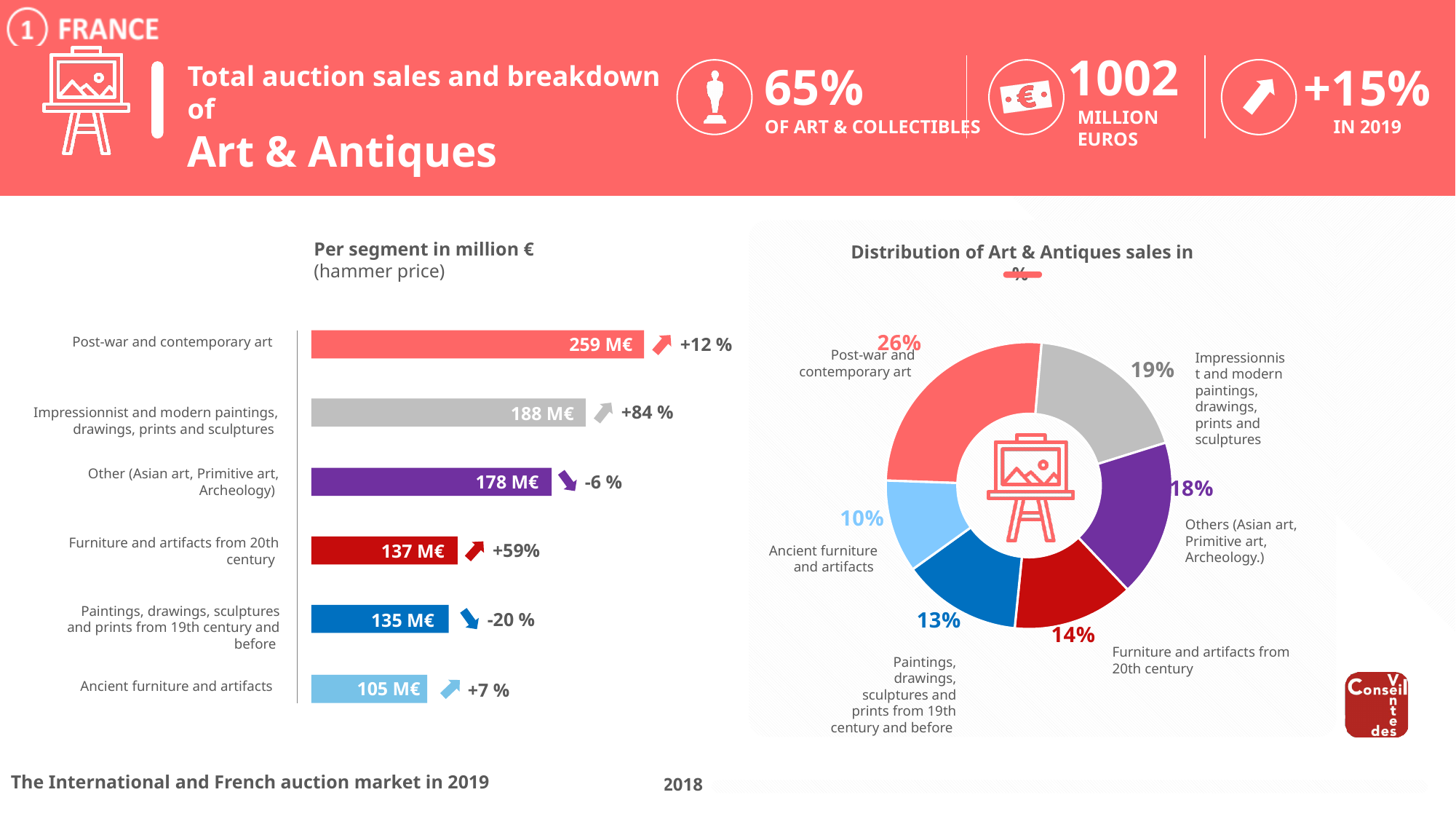
In the bar chart 'Per segment in million €', what is the difference between Post-war and contemporary art and Impressionnist and modern paintings, drawings, prints and sculptures? 71 M€ In the bar chart 'Per segment in million €', which segment has the lowest value? Ancient furniture and artifacts In the bar chart 'Per segment in million €', what percentage change is shown next to the Impressionnist and modern paintings, drawings, prints and sculptures bar? +84 % In the bar chart 'Per segment in million €', which segment has the highest value? Post-war and contemporary art What kind of chart is the chart titled 'Per segment in million €'? Bar chart How many segments are shown in the bar chart 'Per segment in million €'? 6 In the bar chart 'Per segment in million €', which is larger: Furniture and artifacts from 20th century or Paintings, drawings, sculptures and prints from 19th century and before? Furniture and artifacts from 20th century In the donut chart 'Distribution of Art & Antiques sales in %', what share does Post-war and contemporary art have? 26% In the bar chart 'Per segment in million €', what is the value for Post-war and contemporary art? 259 M€ In the donut chart 'Distribution of Art & Antiques sales in %', what share does Ancient furniture and artifacts have? 10% In the donut chart 'Distribution of Art & Antiques sales in %', which segment has the smallest share? Ancient furniture and artifacts In the bar chart 'Per segment in million €', what is the value for Ancient furniture and artifacts? 105 M€